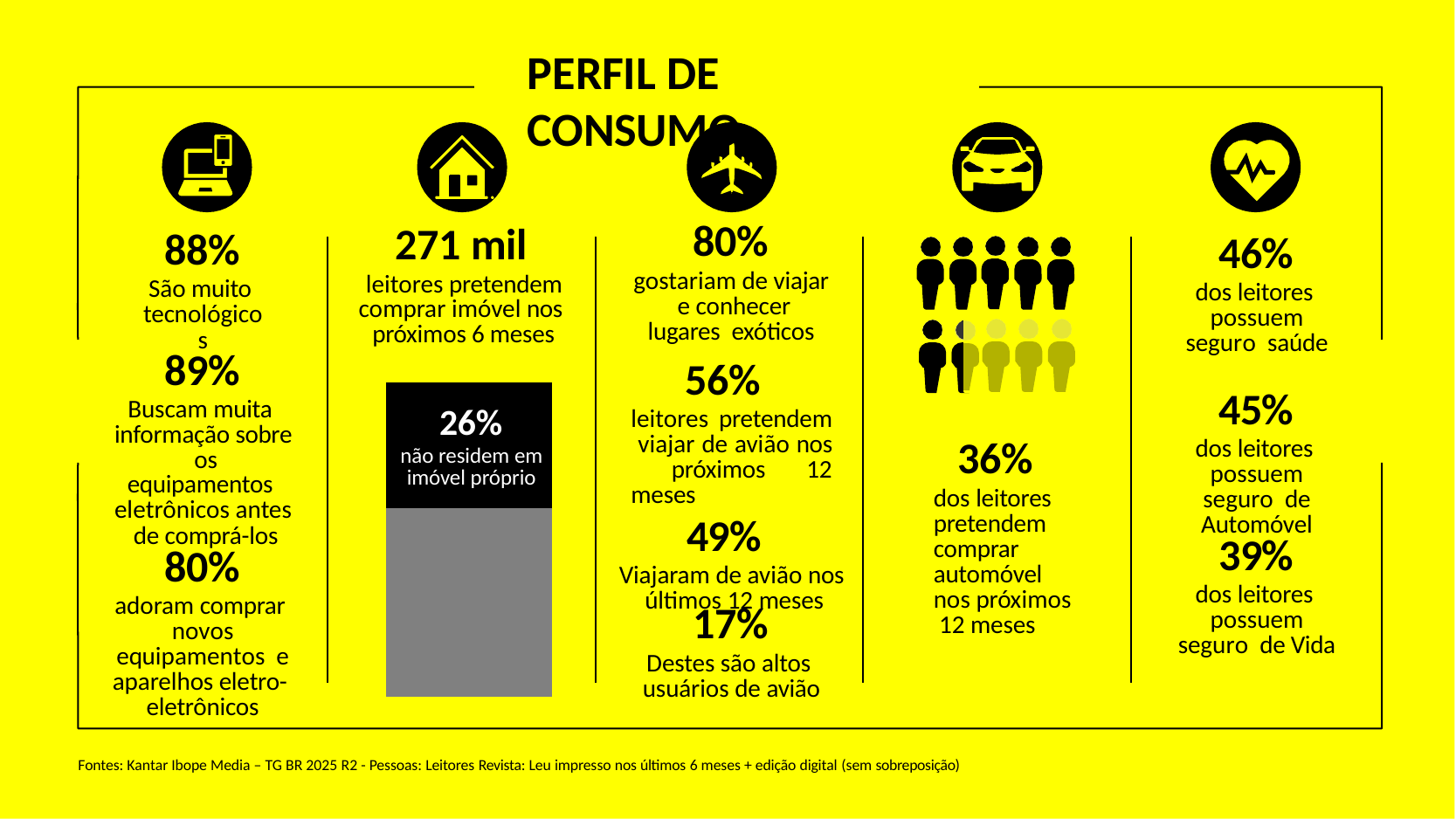
In the bar in the house column, is the black segment larger or smaller than the gray segment? smaller What value is printed on the black segment of the bar in the house (imóvel) column? 26% Is the value labelled on the black segment of the bar in the house column greater or less than 50%? less What does the 36% below the people pictogram represent? dos leitores pretendem comprar automóvel nos próximos 12 meses What percentage is printed below the people pictogram in the car column? 36% How many person icons are shown in the pictogram in the car column? 10 What does the 26% label on the bar in the house column represent? não residem em imóvel próprio